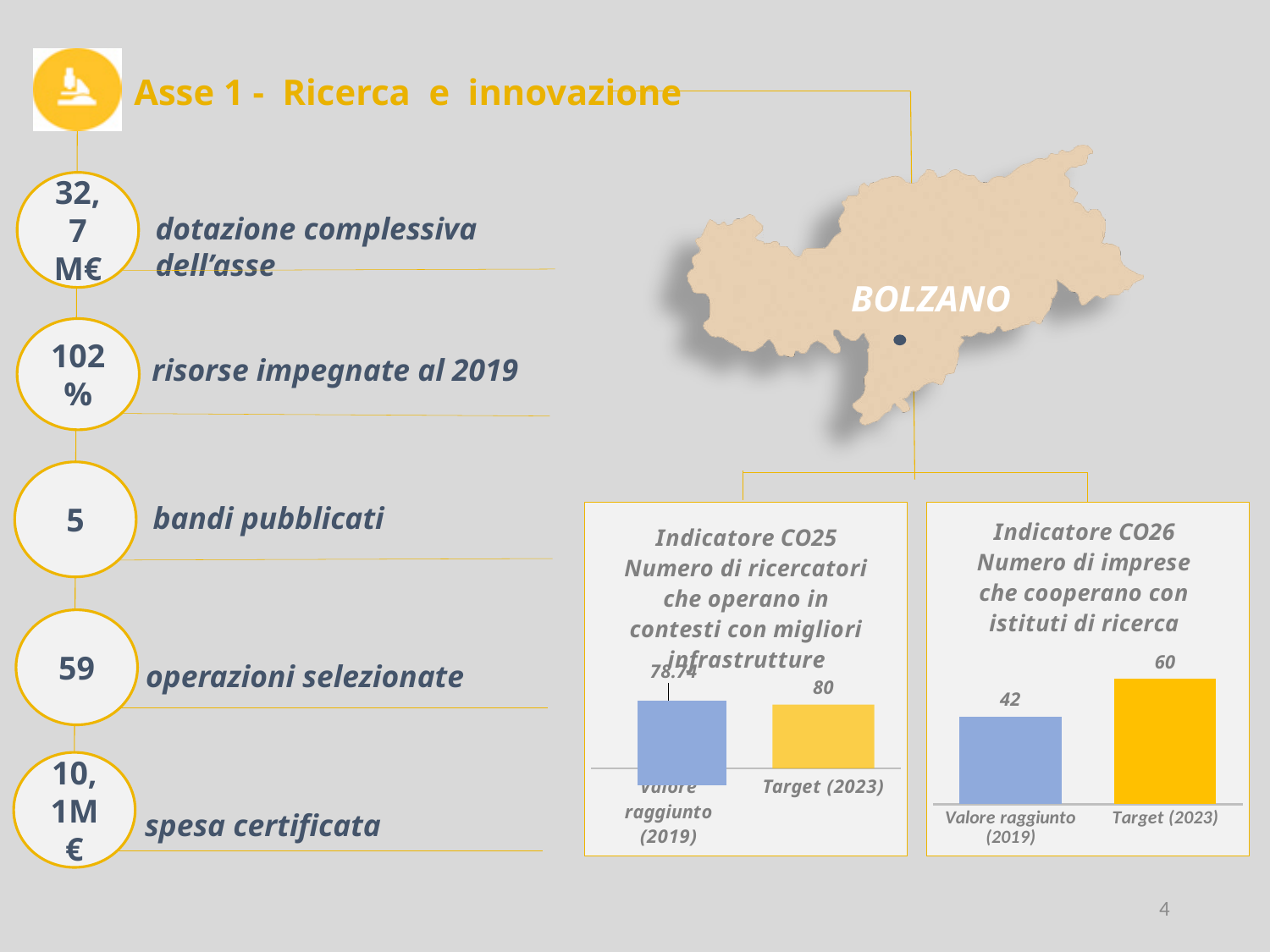
In the Indicatore CO26 chart, which category has the lowest value? Valore raggiunto (2019) In the Indicatore CO25 chart, what is the value for Target (2023)? 80 In the Indicatore CO25 chart, what is the difference between Target (2023) and Valore raggiunto (2019)? 1.26 How many bars are shown in the Indicatore CO25 chart? 2 What kind of chart is the Indicatore CO26 chart? bar chart In the Indicatore CO26 chart, what is the value for Valore raggiunto (2019)? 42 In the Indicatore CO26 chart, what is the value for Target (2023)? 60 What is the title of the chart on the right of the slide? Indicatore CO26 Numero di imprese che cooperano con istituti di ricerca In the Indicatore CO26 chart, what is the difference between Target (2023) and Valore raggiunto (2019)? 18 In the Indicatore CO25 chart, what is the value for Valore raggiunto (2019)? 78.74 In the Indicatore CO26 chart, is the value for Valore raggiunto (2019) larger or smaller than the value for Target (2023)? smaller In the Indicatore CO26 chart, which category has the highest value? Target (2023)